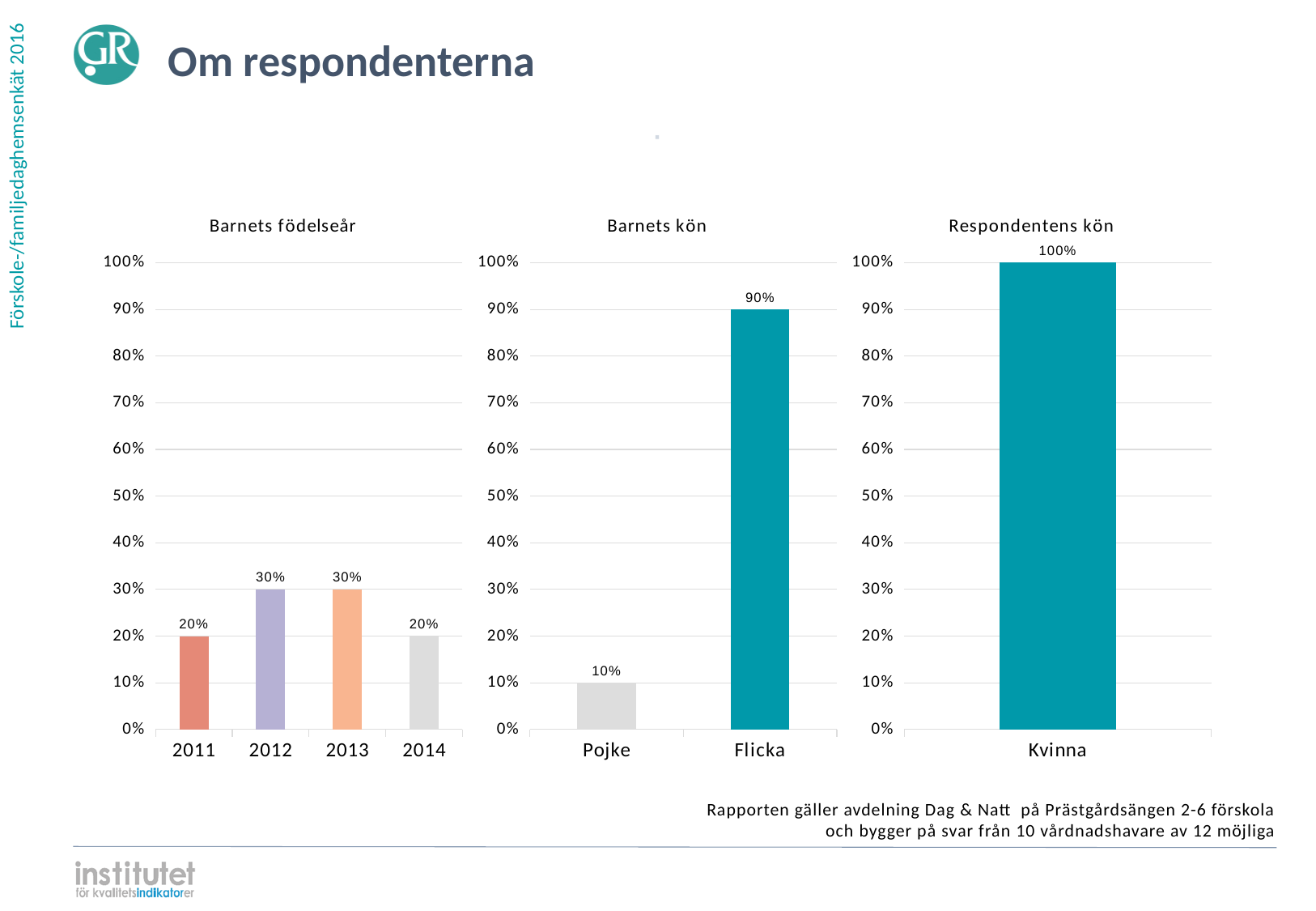
In the 'Barnets kön' chart, which category has the highest value? Flicka In the 'Barnets födelseår' chart, what is the difference between the values for 2012 and 2014? 10% In the 'Barnets födelseår' chart, which is larger, the value for 2011 or the value for 2012? 2012 In the 'Barnets kön' chart, what is the value for Pojke? 10% How many charts are shown on the slide? 3 In the 'Barnets födelseår' chart, what is the value for 2011? 20% In the 'Barnets kön' chart, what is the difference between the values for Flicka and Pojke? 80% What kind of chart is the 'Respondentens kön' chart? Bar chart In the 'Barnets födelseår' chart, how many categories are shown on the x axis? 4 In the 'Respondentens kön' chart, what is the value for Kvinna? 100% In the 'Barnets födelseår' chart, what is the value for 2013? 30% In the 'Barnets kön' chart, what is the value for Flicka? 90%